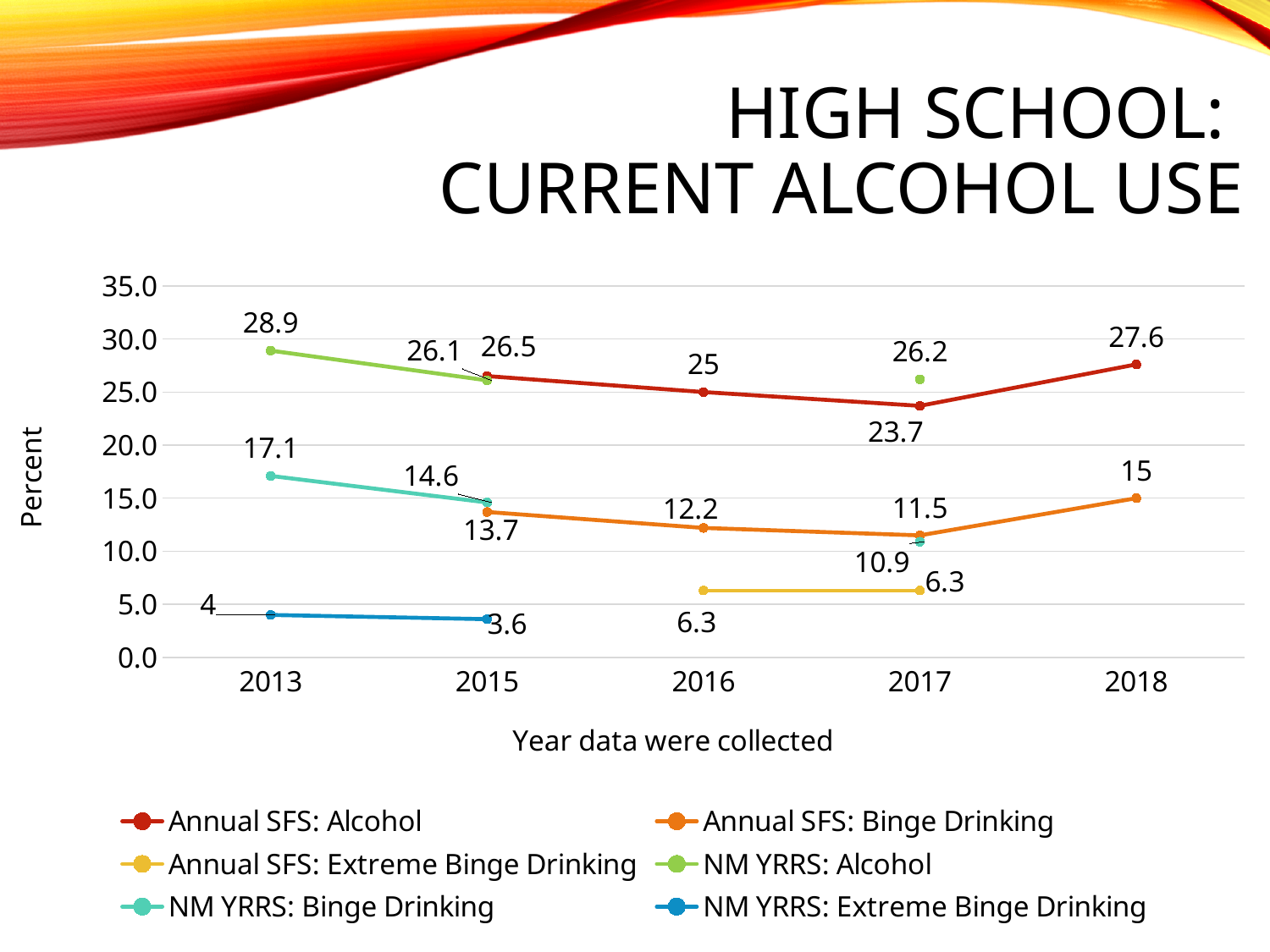
What is the value for NM YRRS: Extreme Binge Drinking in 2015? 3.6 In which year is the Annual SFS: Alcohol series at its lowest? 2017 In 2015, which is larger: NM YRRS: Binge Drinking or Annual SFS: Binge Drinking? NM YRRS: Binge Drinking Does the NM YRRS: Binge Drinking series rise or fall from 2013 to 2017? Fall What is the value for Annual SFS: Binge Drinking in 2017? 11.5 What is the value for Annual SFS: Alcohol in 2018? 27.6 In which year is the Annual SFS: Binge Drinking series at its highest? 2018 What is the value for NM YRRS: Alcohol in 2013? 28.9 What is the difference between the Annual SFS: Alcohol values for 2018 and 2017? 3.9 What is the difference between the NM YRRS: Alcohol values for 2013 and 2015? 2.8 What kind of chart is shown on the slide? Line chart How many series does the legend list? 6